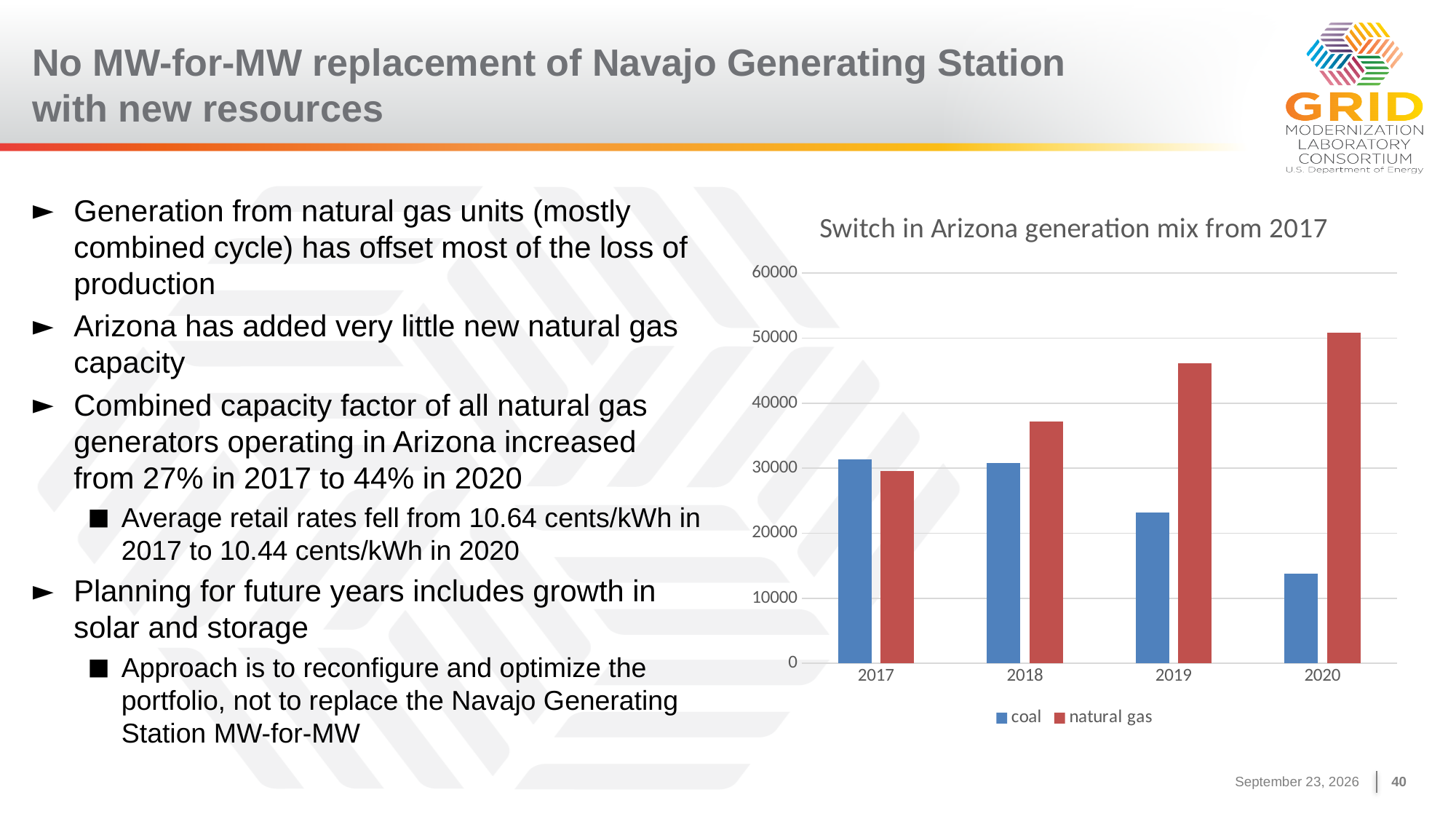
In which year is the coal value lowest? 2020 What kind of chart is shown on the slide? bar chart What is the title of the chart? Switch in Arizona generation mix from 2017 How many series does the chart's legend list? 2 Is the coal value for 2020 greater or less than 20000? less In 2018, which is larger, coal or natural gas? natural gas Which colour represents coal in the chart? blue Do the natural gas values rise or fall from 2017 to 2020? rise Is the coal value for 2019 greater or less than 30000? less Is the natural gas value for 2019 greater or less than 40000? greater How many years are shown on the x axis of the chart? 4 In which year is the natural gas value highest? 2020